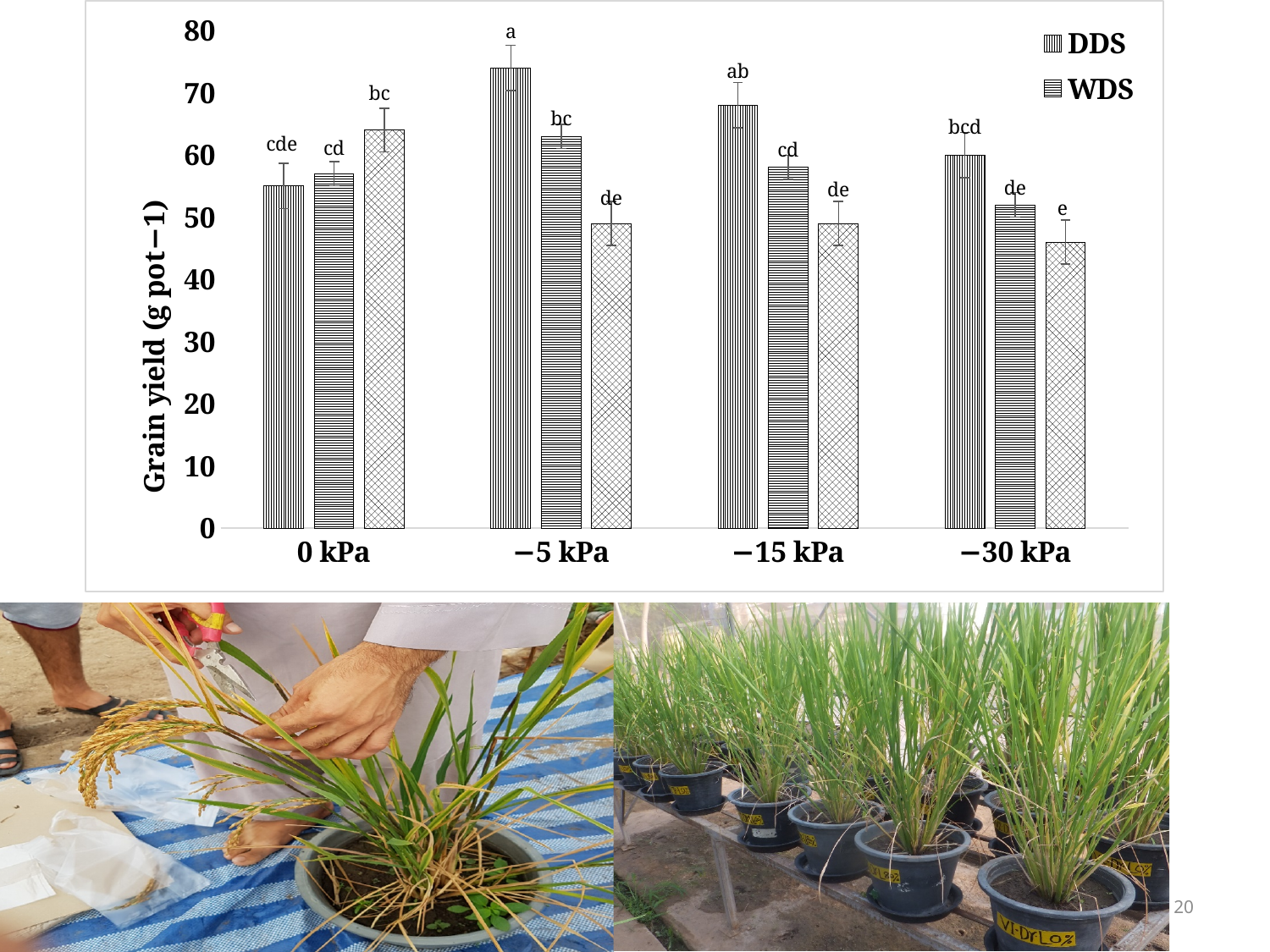
What kind of chart is shown on the slide? bar chart What is the title of the y axis of the chart? Grain yield (g pot−1) How many categories are shown on the x axis of the chart? 4 How many series does the chart's legend list? 2 Is the WDS value at −15 kPa greater or less than 50? greater At −15 kPa, which is larger, the DDS value or the WDS value? DDS Is the WDS value at −30 kPa greater or less than 60? less Which letter label is printed above the DDS bar at −5 kPa? a At which x-axis category is the DDS bar highest? −5 kPa At −5 kPa, which is larger, the DDS value or the WDS value? DDS Is the DDS value at −5 kPa greater or less than 70? greater